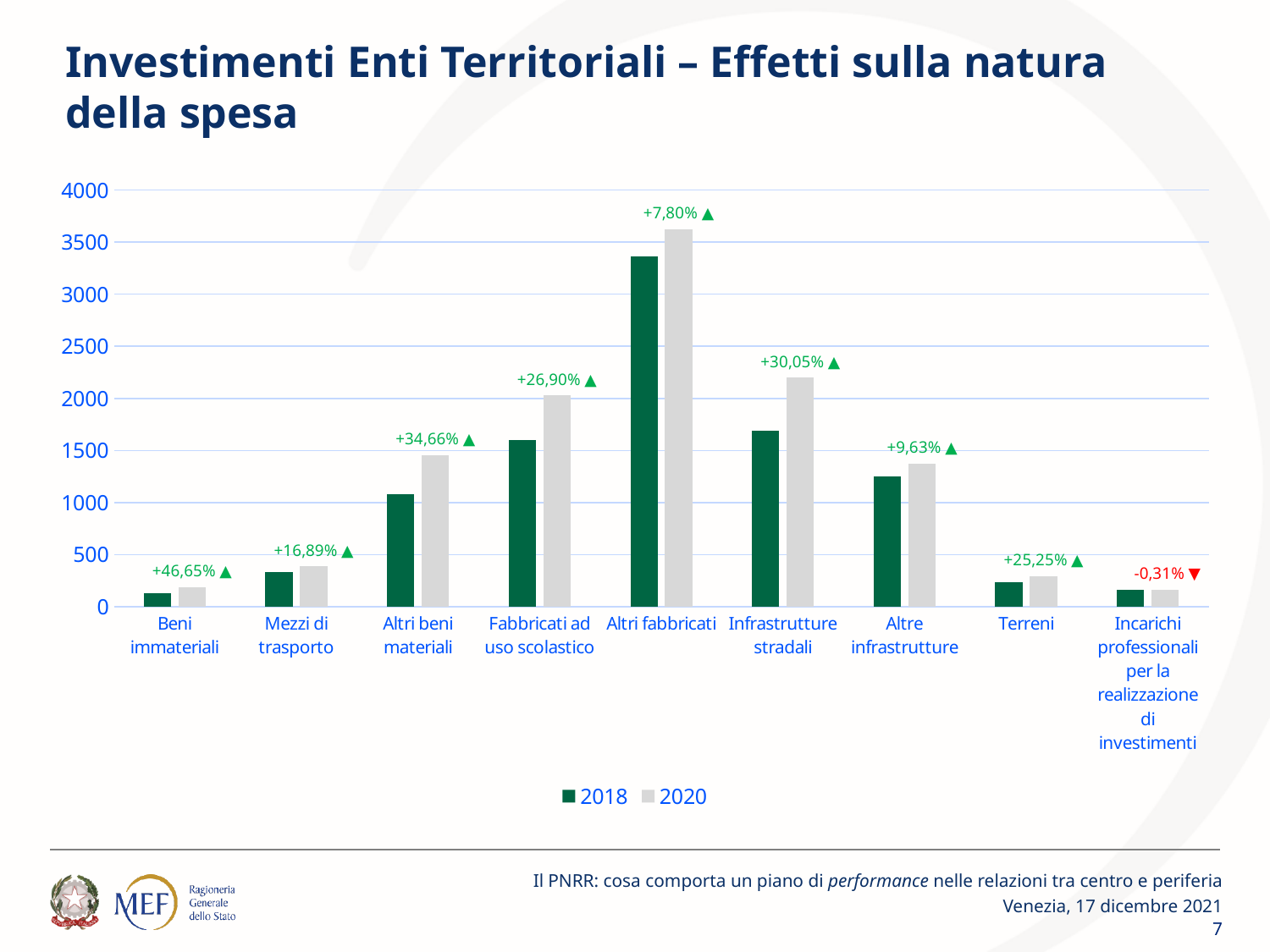
Is the 2020 value for Altri fabbricati greater or less than 3500? greater Is the 2018 value for Infrastrutture stradali greater or less than 2000? less Which category has the tallest bars? Altri fabbricati How many series does the legend list? 2 What kind of chart is shown on the slide? Bar chart What percentage change is labelled above the bars for Infrastrutture stradali? +30,05% What percentage change is labelled for Incarichi professionali per la realizzazione di investimenti? -0,31% How many categories are shown on the x axis? 9 Which category has the lowest percentage change label? Incarichi professionali per la realizzazione di investimenti What percentage change is labelled above the bars for Beni immateriali? +46,65% Which is larger: the 2020 value for Fabbricati ad uso scolastico or the 2020 value for Altri beni materiali? Fabbricati ad uso scolastico Which category has the highest percentage change label? Beni immateriali